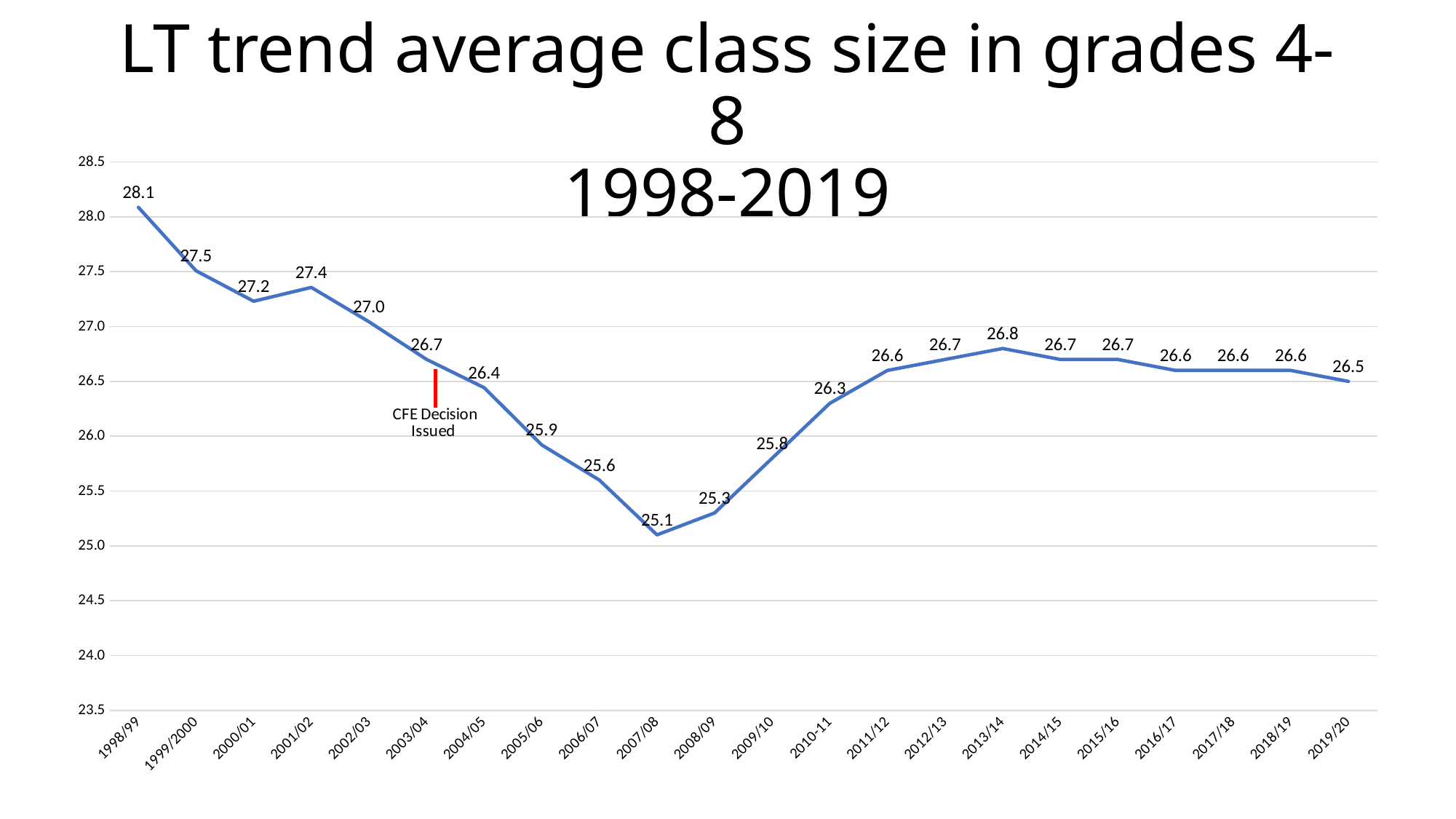
Did the average class size rise or fall between 1998/99 and 2007/08? Fall What was the average class size in 2013/14? 26.8 What was the average class size in 2007/08? 25.1 What event does the red marker on the chart indicate? CFE Decision Issued What type of chart is shown on the slide? Line chart How many school years are plotted on the chart? 22 What is the difference between the average class size in 1998/99 and in 2007/08? 3.0 Which year had a larger average class size, 2003/04 or 2010/11? 2003/04 What was the average class size in 1998/99? 28.1 Which school year had the highest average class size? 1998/99 What was the average class size in 2019/20? 26.5 Which school year had the lowest average class size? 2007/08